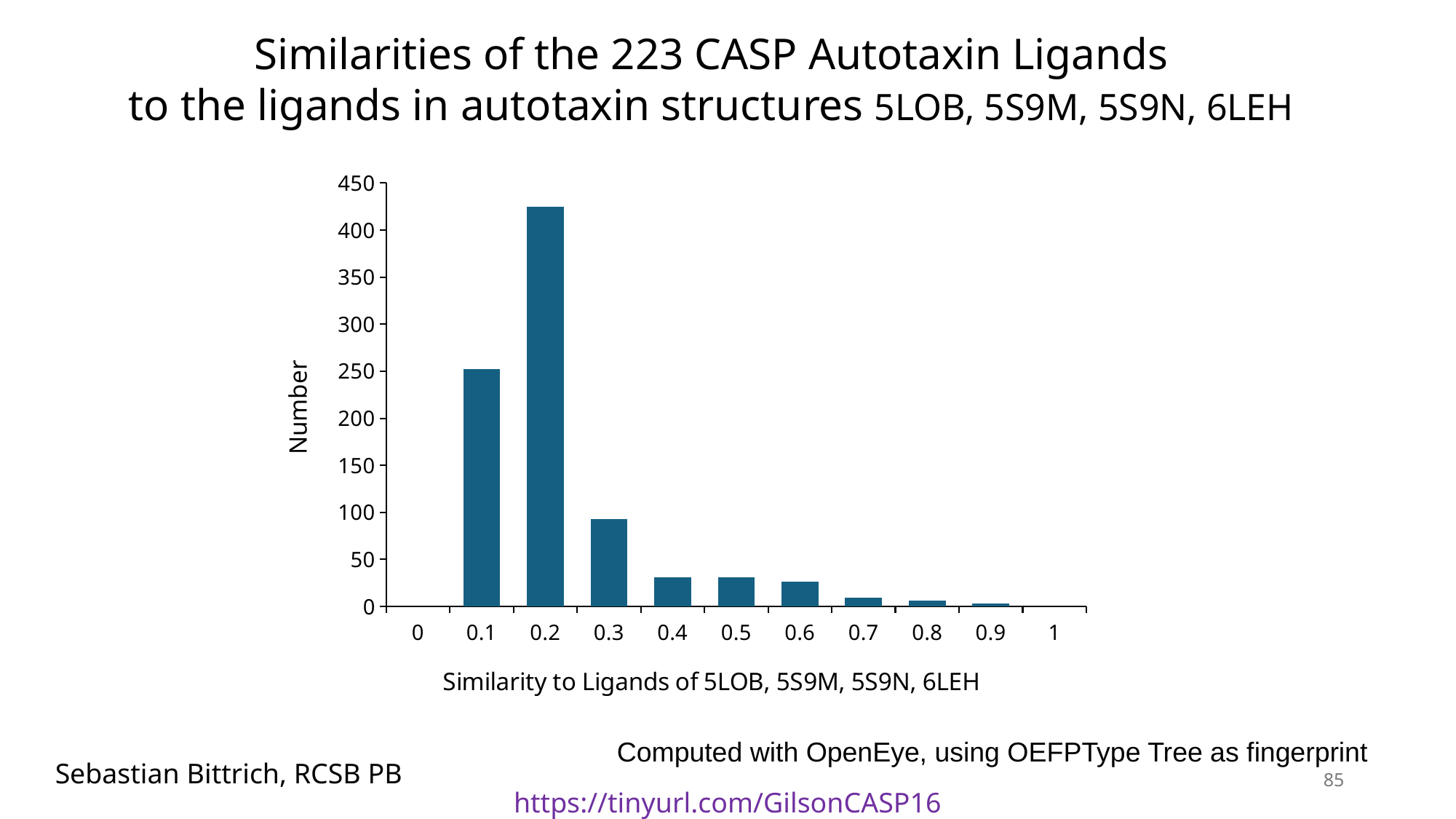
Is the value for the 0.3 similarity bin greater or less than 100? less Which similarity bin has the tallest bar? 0.2 What is the label of the y axis? Number Is the value for the 0.1 similarity bin greater or less than 200? greater How many similarity bins are labelled on the x axis? 11 Which is larger, the value for the 0.1 bin or the value for the 0.3 bin? 0.1 What kind of chart is shown on the slide? bar chart Is the value for the 0.1 similarity bin greater or less than 300? less Which is larger, the value for the 0.2 bin or the value for the 0.1 bin? 0.2 From the 0.2 bin to the 0.9 bin, do the values rise or fall along the x axis? fall